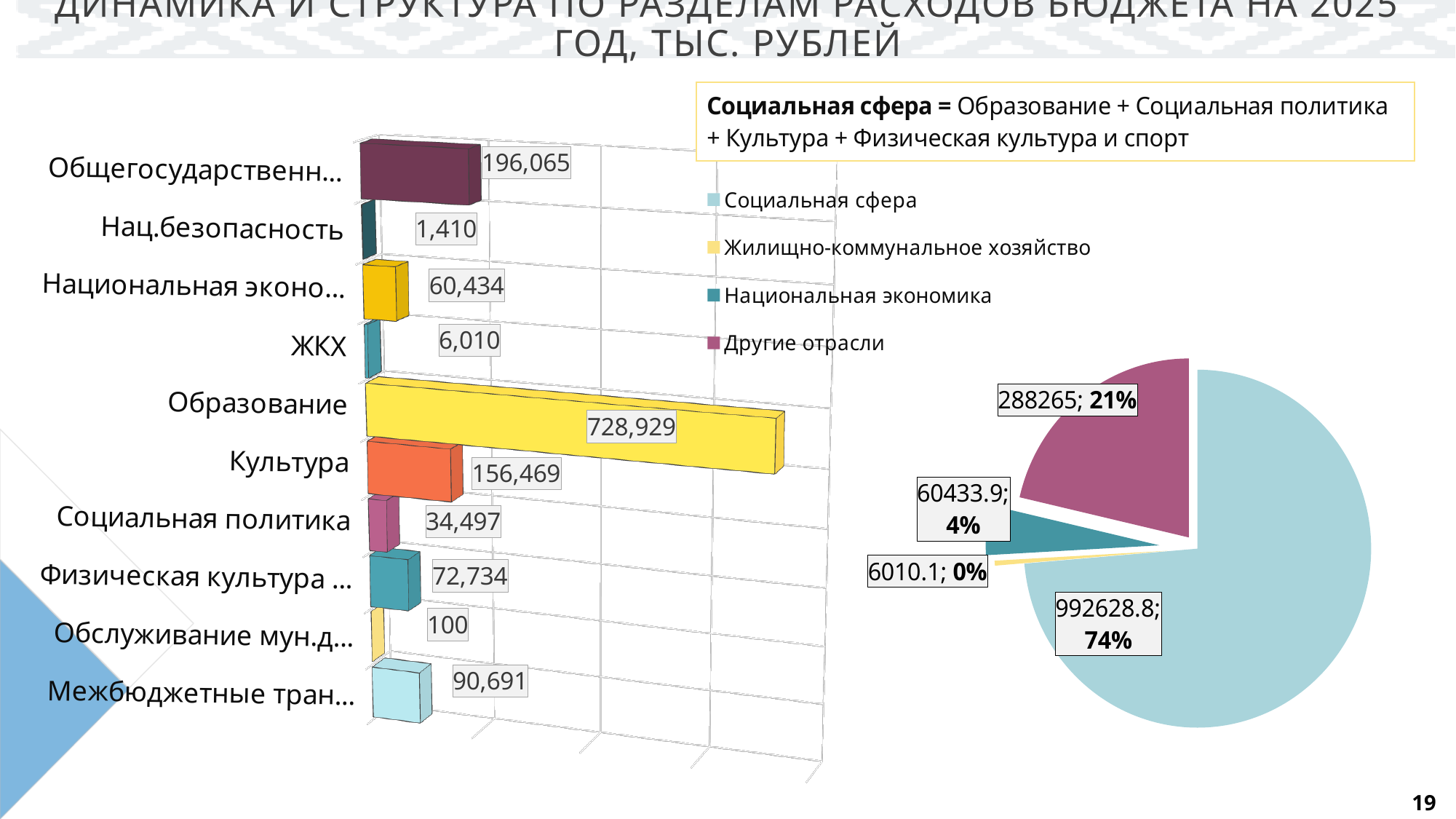
In the bar chart on the left, what is the difference between the values for Культура and Социальная политика? 121,972 In the bar chart on the left, which category has the highest value? Образование In the bar chart on the left, what is the value for Образование? 728,929 In the pie chart on the right, what share does Социальная сфера have? 74% How many categories are shown in the bar chart on the left? 10 In the bar chart on the left, what is the value for ЖКХ? 6,010 How many entries does the legend of the pie chart on the right list? 4 In the bar chart on the left, what is the value for Культура? 156,469 What type of chart is the chart on the left? bar chart In the bar chart on the left, which is larger: the value for Физическая культура ... or the value for Межбюджетные тран...? Межбюджетные тран... In the pie chart on the right, what value is shown for Другие отрасли? 288265 In the bar chart on the left, which category has the lowest value? Обслуживание мун.д...